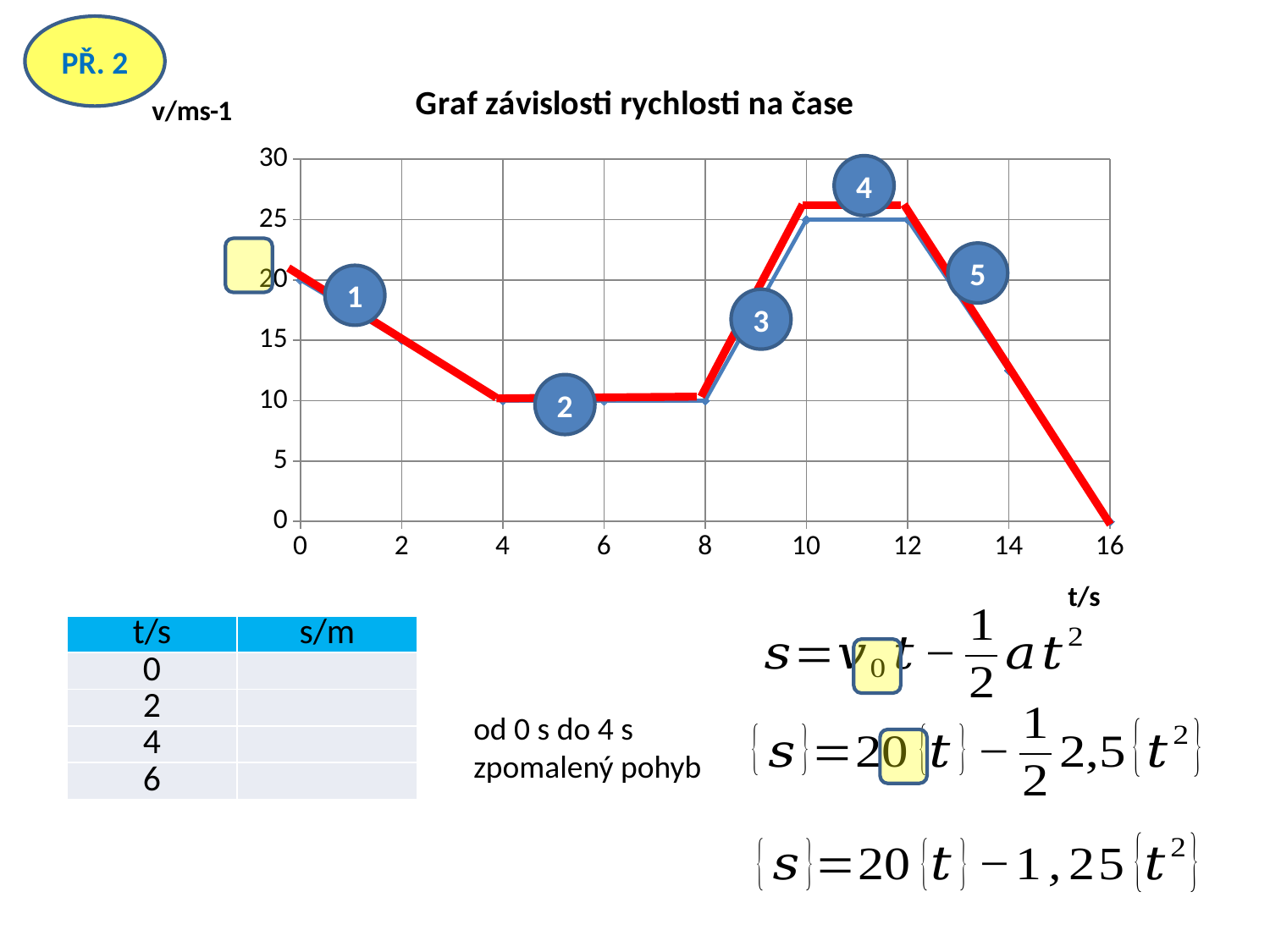
What is the lowest velocity value on the chart? 0 What is the highest velocity value reached on the chart? 25 Does the velocity rise, fall or stay constant between t = 4 s and t = 8 s? stays constant What kind of chart is shown on the slide? line chart Does the velocity rise or fall between t = 12 s and t = 16 s? fall Is the velocity at t = 0 s greater or less than 15? greater What is the velocity value at t = 4 s? 10 Which is larger, the velocity at t = 4 s or at t = 10 s? t = 10 s What is the velocity value at t = 12 s? 25 What is the title of the chart? Graf závislosti rychlosti na čase What is the velocity value at t = 10 s? 25 What is the velocity value at t = 16 s? 0